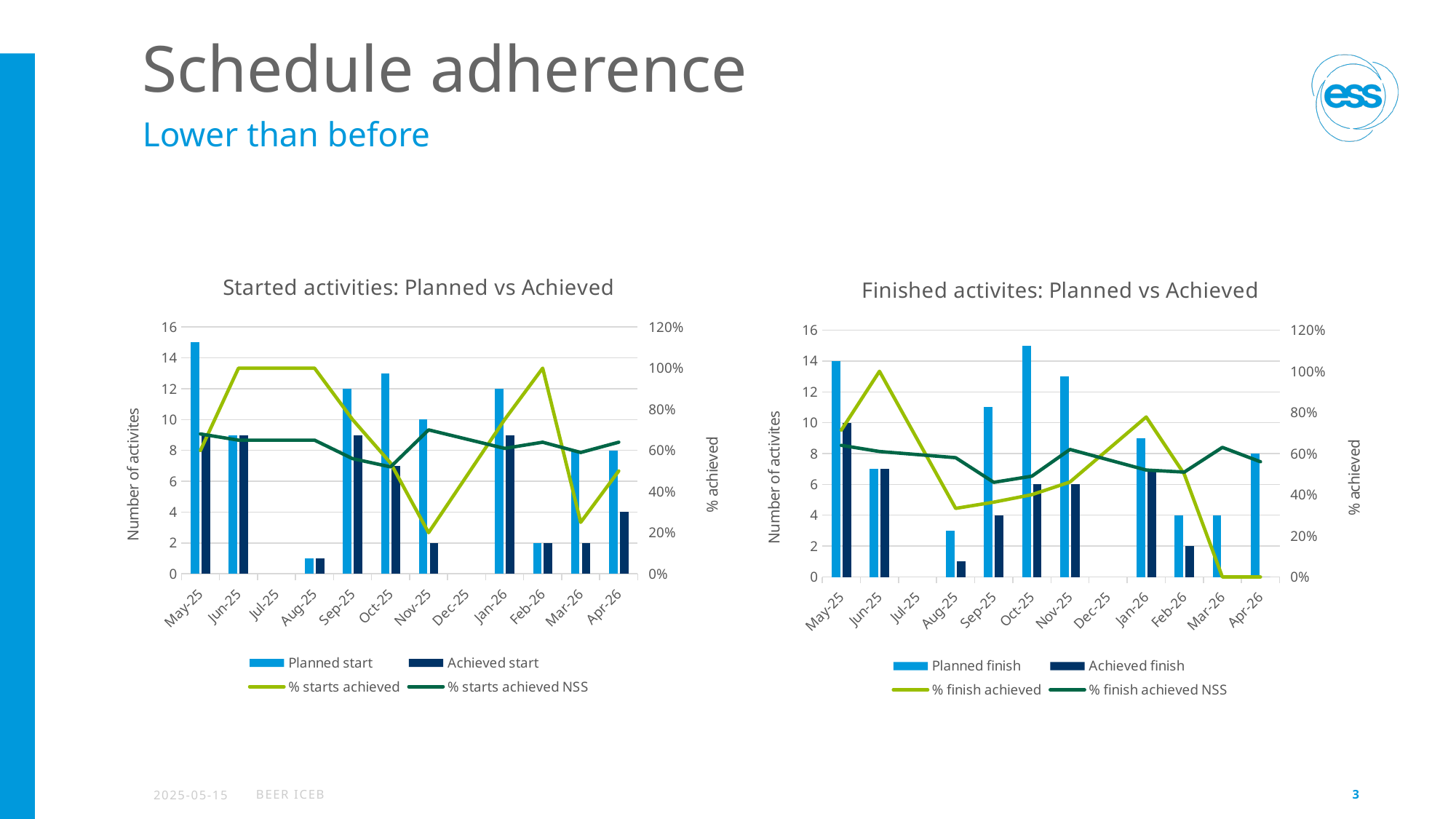
In the 'Finished activites: Planned vs Achieved' chart, which month has the highest Planned finish bar? Oct-25 In the 'Started activities: Planned vs Achieved' chart, which is larger for Nov-25: Planned start or Achieved start? Planned start In the 'Started activities: Planned vs Achieved' chart, is the Planned start value for Oct-25 greater or less than 12? greater In the 'Started activities: Planned vs Achieved' chart, which month has the highest Planned start bar? May-25 In the 'Finished activites: Planned vs Achieved' chart, what is the difference between Planned finish and Achieved finish for May-25? 4 In the 'Started activities: Planned vs Achieved' chart, what is the Planned start value for Sep-25? 12 In the 'Finished activites: Planned vs Achieved' chart, what is the Achieved finish value for Oct-25? 6 In the 'Finished activites: Planned vs Achieved' chart, what is the Planned finish value for May-25? 14 How many months are shown on the x axis of the 'Started activities: Planned vs Achieved' chart? 12 What kind of chart is the 'Started activities: Planned vs Achieved' chart? A combined bar and line chart How many series does the legend of the 'Finished activites: Planned vs Achieved' chart list? 4 In the 'Finished activites: Planned vs Achieved' chart, what is the '% finish achieved' value for Mar-26? 0%